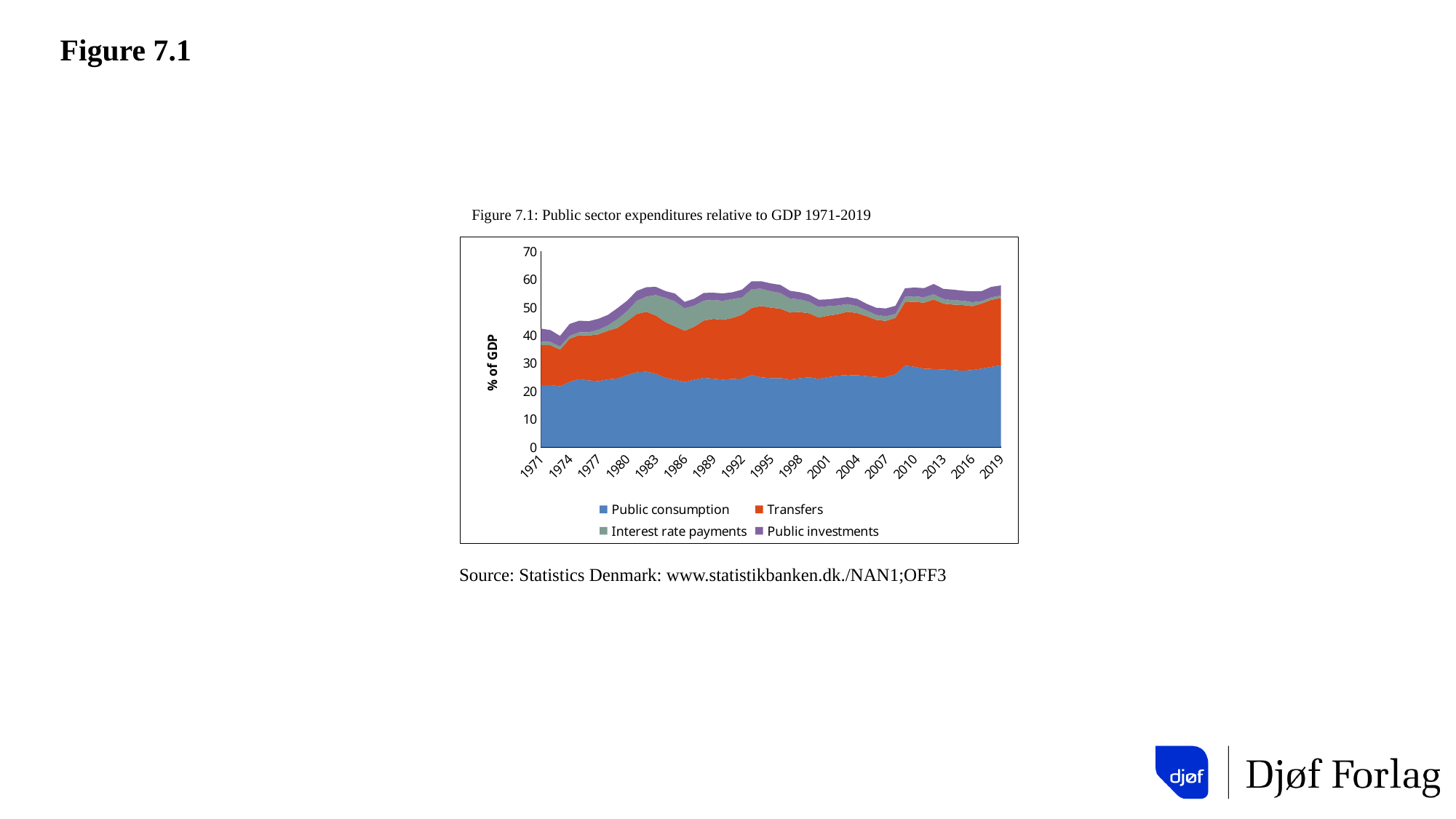
What is the label on the vertical axis? % of GDP Is the total public sector expenditure in 1983 greater or less than 50? greater Is the total public sector expenditure in 2019 greater or less than 50? greater Is the total public sector expenditure in 1971 greater or less than 40? greater Does the total public sector expenditure rise or fall from 1971 to 1983? rise What kind of chart is shown on the slide? Stacked area chart Which series is the smallest component of expenditure in 2019? Interest rate payments Which series is the largest component of expenditure in 2019? Public consumption How many series does the legend list? 4 In 1971, which is larger: Public consumption or Transfers? Public consumption What is the title of the chart? Figure 7.1: Public sector expenditures relative to GDP 1971-2019